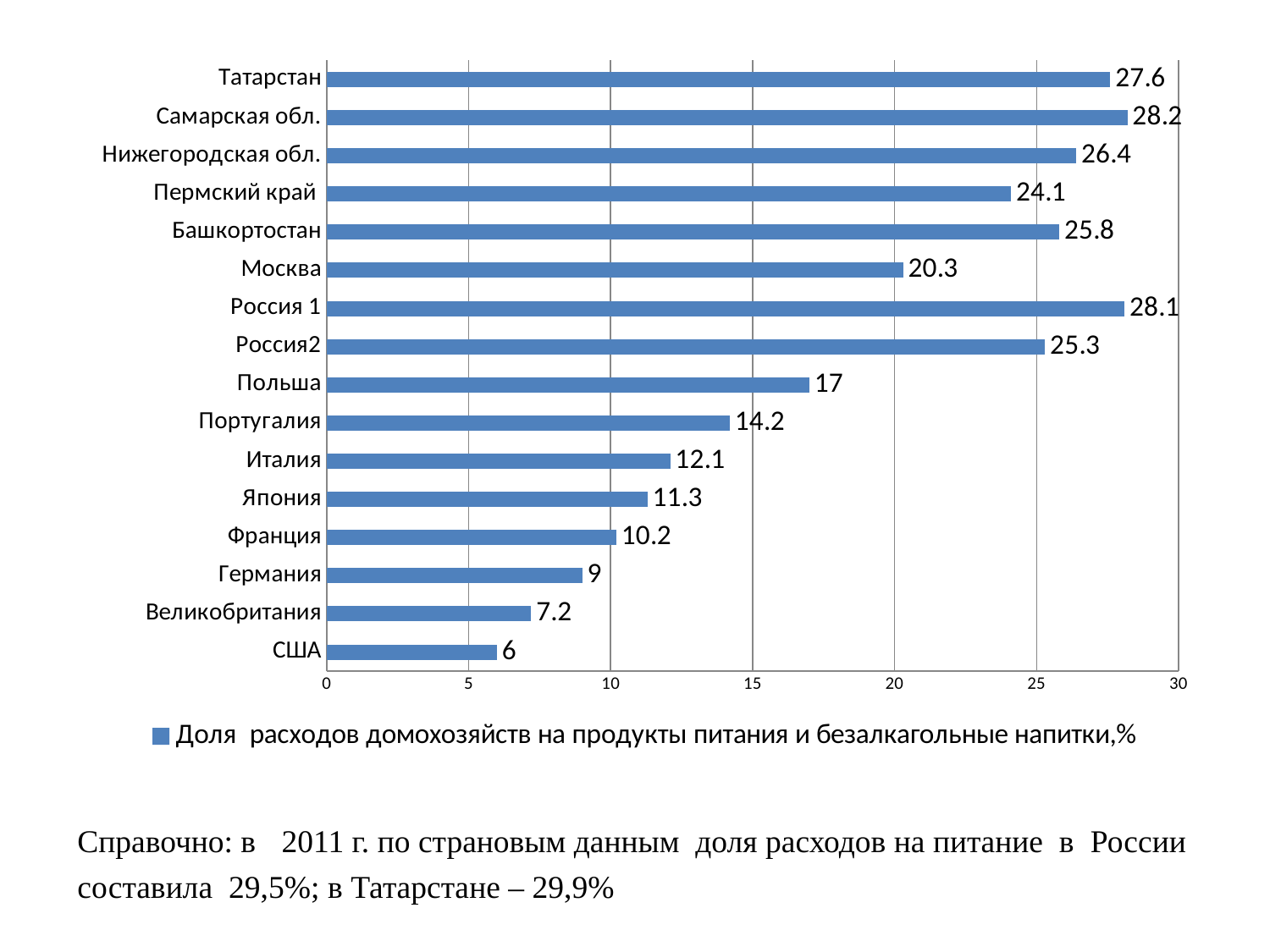
Which is larger, the value for Пермский край or the value for Башкортостан? Башкортостан What is the value for Москва? 20.3 What is the difference between the values for Татарстан and США? 21.6 Which category has the lowest value? США What is the difference between the values for Польша and Португалия? 2.8 How many categories are shown in the chart? 16 What is the value for Германия? 9 What is the value for Татарстан? 27.6 What kind of chart is shown on the slide? bar chart What is the legend entry of the series shown in the chart? Доля расходов домохозяйств на продукты питания и безалкагольные напитки,% Is the value for Япония greater or less than 10? greater How many series does the legend list? 1